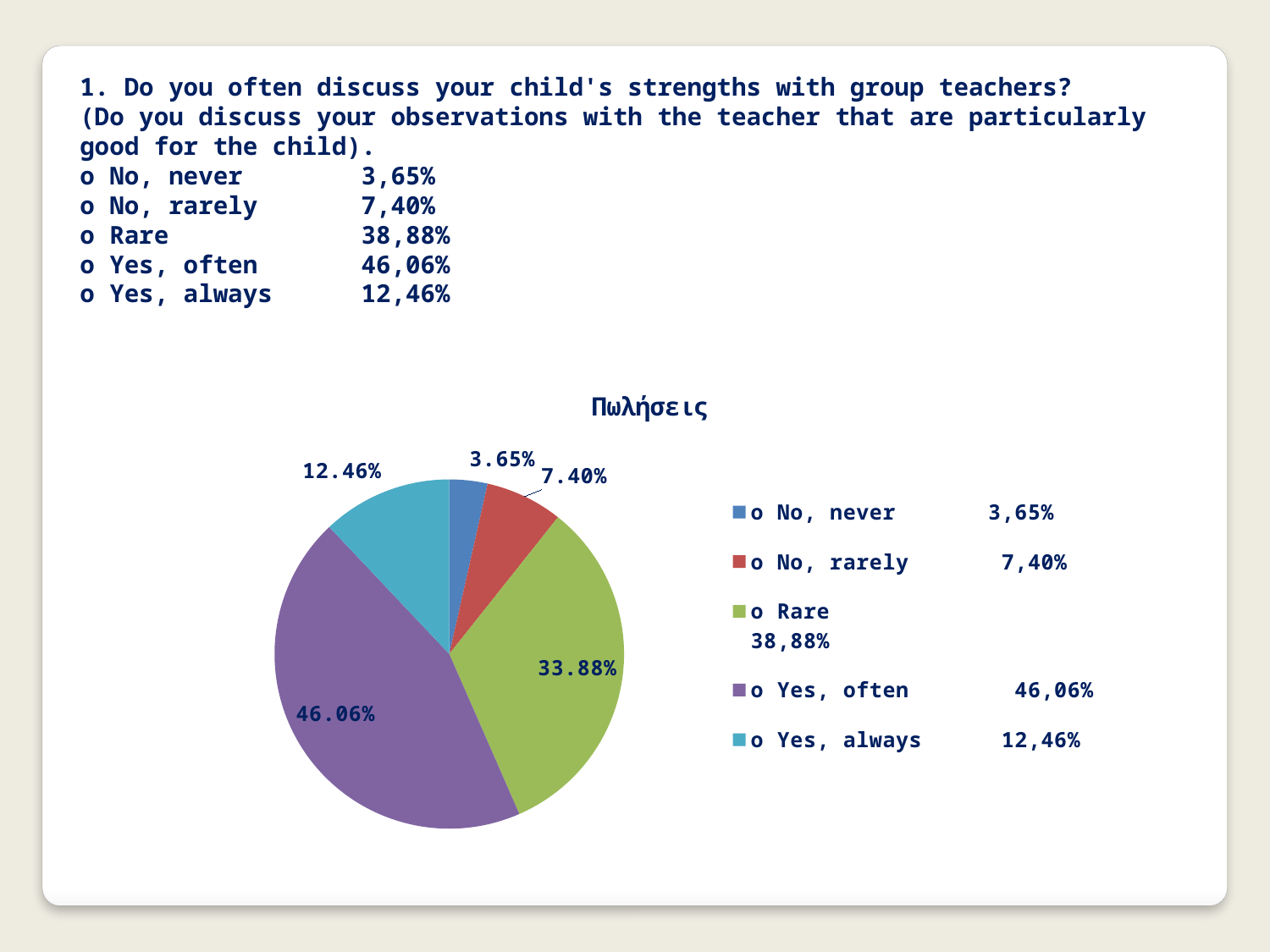
What is the data label on the pie slice for "No, rarely"? 7.40% What is the difference between the "Yes, often" slice and the "Yes, always" slice? 33.60% What kind of chart is shown on the slide? pie chart What share of the pie does "Yes, always" represent? 12.46% What is the title of the pie chart? Πωλήσεις What is the data label on the pie slice for "Yes, often"? 46.06% Which slice is larger, "Yes, always" or "No, rarely"? Yes, always Which category has the smallest slice of the pie? No, never What colour is the "Yes, often" slice in the pie chart? purple Which category has the largest slice of the pie? Yes, often What is the data label on the pie slice for "No, never"? 3.65% How many slices does the pie chart have? 5